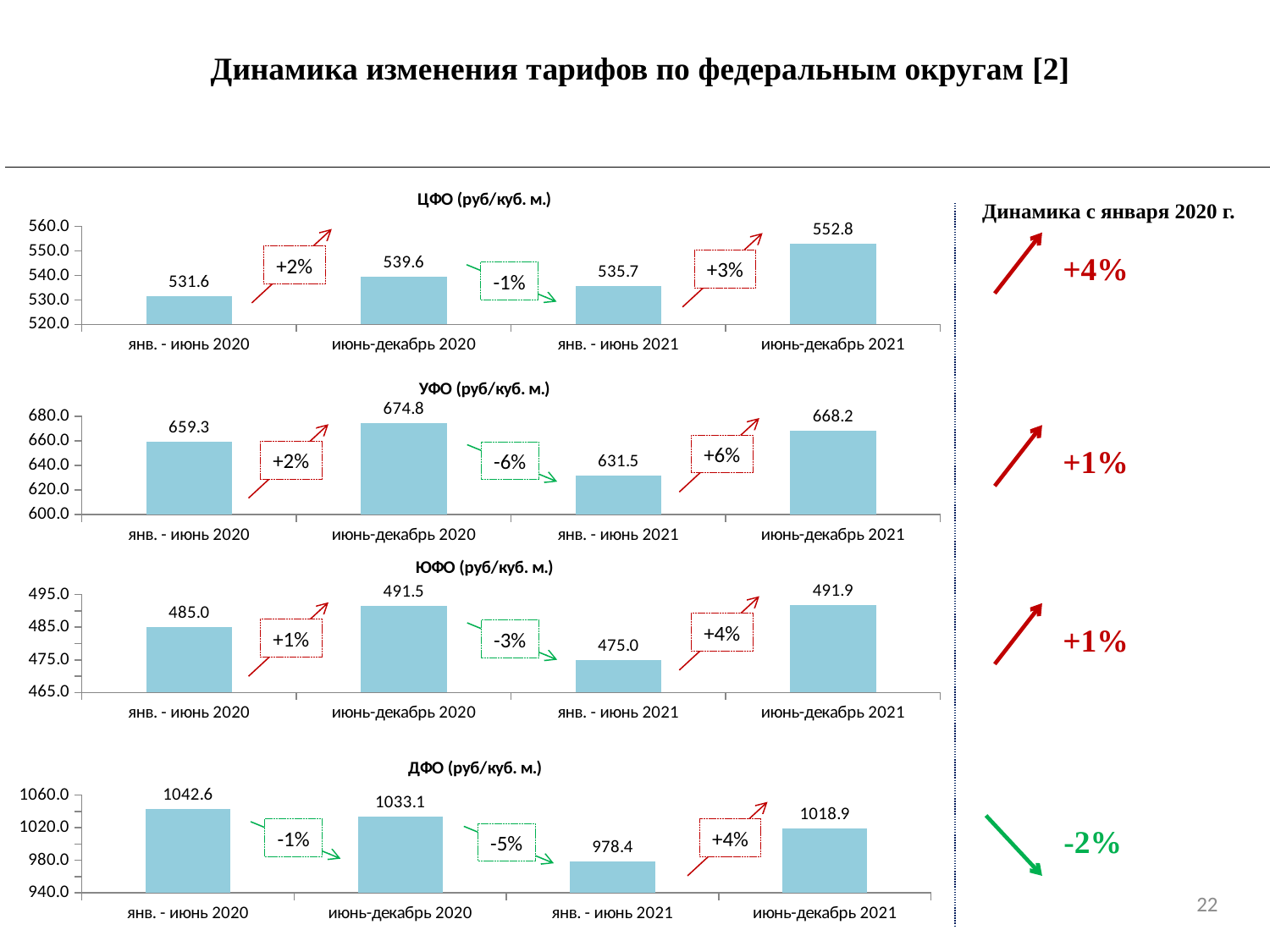
In the ЮФО (руб/куб. м.) chart, what is the value for июнь-декабрь 2020? 491.5 In the УФО (руб/куб. м.) chart, which period has the highest value? июнь-декабрь 2020 In the ДФО (руб/куб. м.) chart, which period has the lowest value? янв. - июнь 2021 In the ЦФО (руб/куб. м.) chart, what is the difference between the values for июнь-декабрь 2021 and янв. - июнь 2020? 21.2 What kind of chart is the ДФО (руб/куб. м.) chart? bar chart In the УФО (руб/куб. м.) chart, what is the value for янв. - июнь 2021? 631.5 In the ЦФО (руб/куб. м.) chart, which period has the lowest value? янв. - июнь 2020 How many periods (categories) are shown on the x axis of the УФО (руб/куб. м.) chart? 4 In the ДФО (руб/куб. м.) chart, what is the value for янв. - июнь 2020? 1042.6 In the ЮФО (руб/куб. м.) chart, which is larger: the value for янв. - июнь 2020 or the value for янв. - июнь 2021? янв. - июнь 2020 In the ЦФО (руб/куб. м.) chart, what is the value for июнь-декабрь 2021? 552.8 In the ДФО (руб/куб. м.) chart, what is the difference between the values for янв. - июнь 2020 and янв. - июнь 2021? 64.2